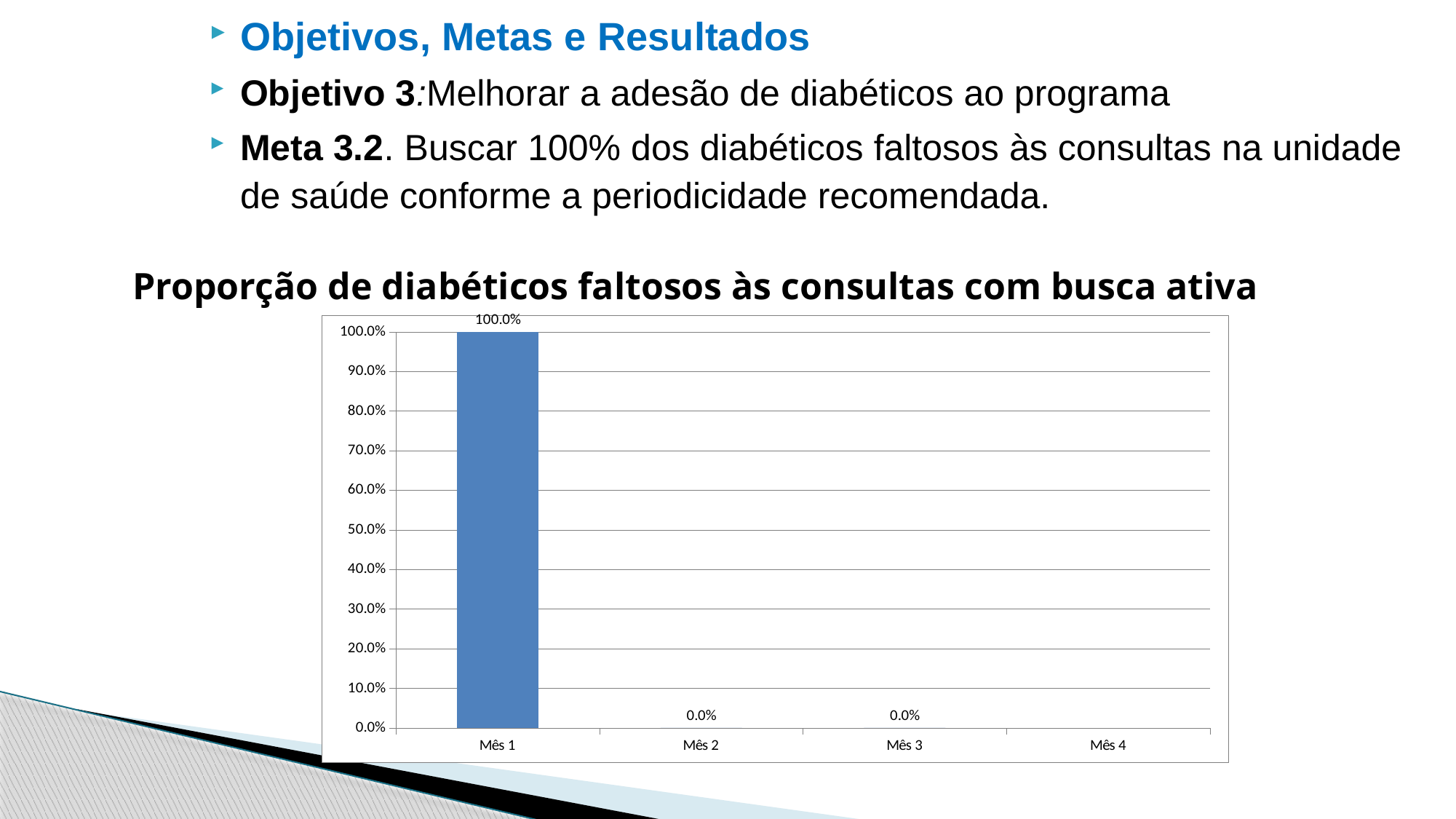
Is the value for Mês 1 greater or less than 50.0%? greater What is the difference between the values for Mês 1 and Mês 2? 100.0% What is the highest value shown on the y axis? 100.0% What kind of chart is shown on the slide? bar chart What is the value for Mês 1? 100.0% Which month has the highest value? Mês 1 Do the values rise or fall from Mês 1 to Mês 2? fall What is the value for Mês 3? 0.0% Which is larger, the value for Mês 1 or the value for Mês 3? Mês 1 What is the value for Mês 2? 0.0% What is the title of the chart? Proporção de diabéticos faltosos às consultas com busca ativa How many months are shown on the x axis? 4